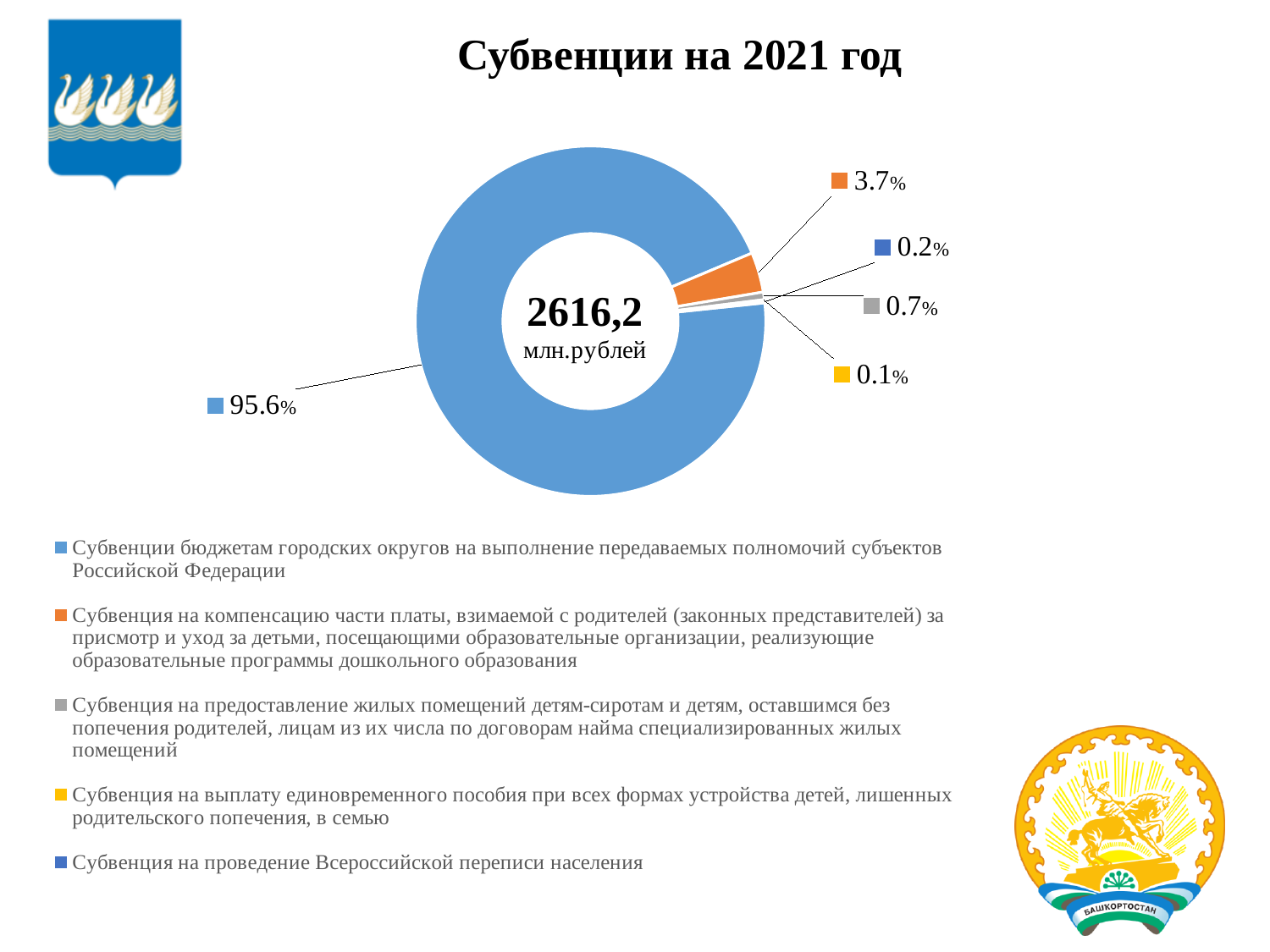
Which category has the smallest share of the chart? Субвенция на выплату единовременного пособия при всех формах устройства детей, лишенных родительского попечения, в семью What share does the orange slice 'Субвенция на компенсацию части платы, взимаемой с родителей...' represent? 3.7% What type of chart is shown on the slide? Pie (donut) chart Which category has the largest share of the chart? Субвенции бюджетам городских округов на выполнение передаваемых полномочий субъектов Российской Федерации What is the difference in percentage points between the 3.7% slice and the 0.7% slice? 3.0% What share of the chart does the slice 'Субвенции бюджетам городских округов на выполнение передаваемых полномочий субъектов Российской Федерации' represent? 95.6% What share does the slice 'Субвенция на выплату единовременного пособия при всех формах устройства детей, лишенных родительского попечения, в семью' represent? 0.1% How many categories does the legend list? 5 What is the title of the chart? Субвенции на 2021 год What total value is shown in the centre of the donut chart? 2616,2 млн.рублей